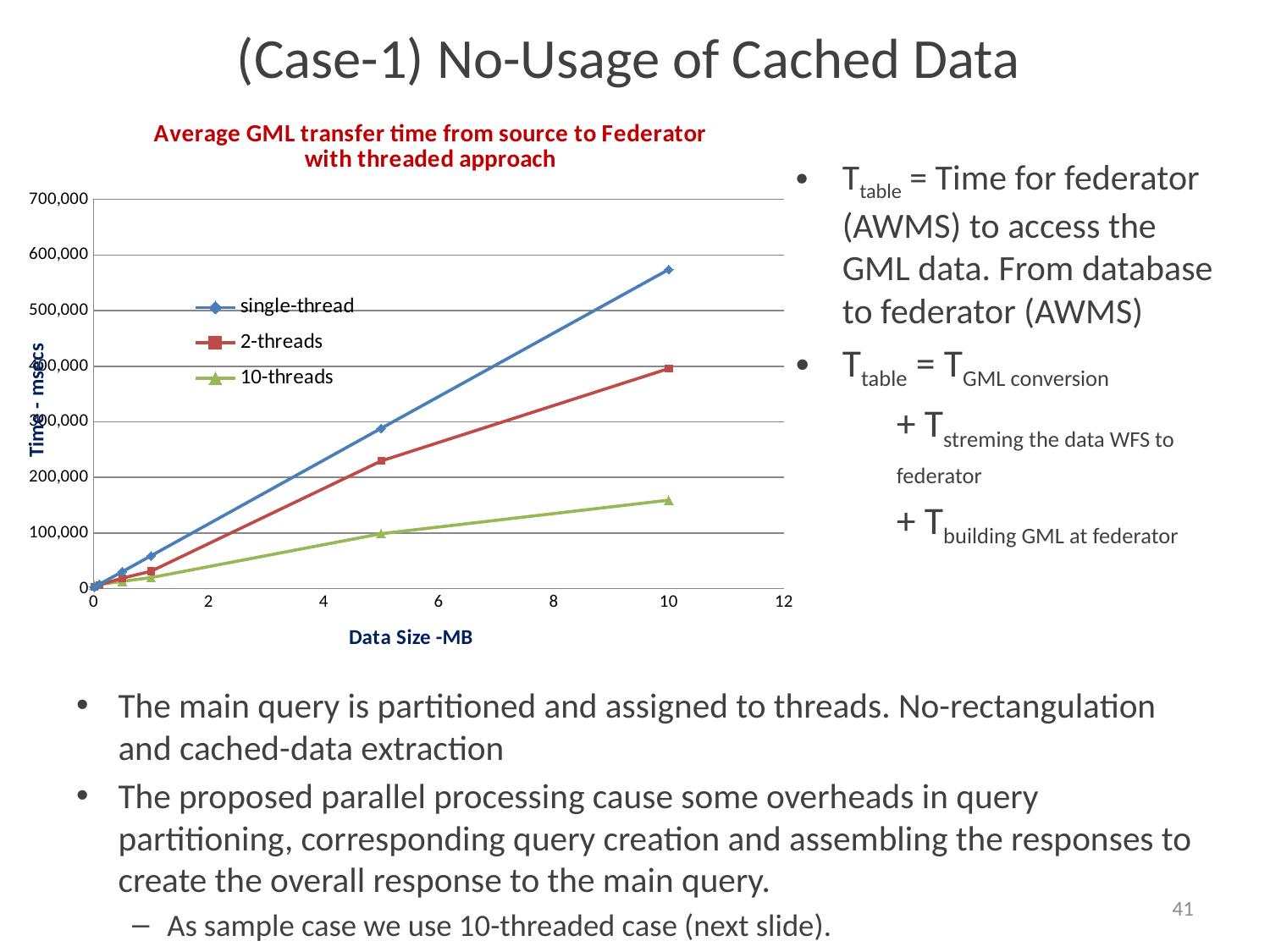
Is the 2-threads transfer time at 10 MB greater or less than 300,000 msecs? greater Is the 2-threads transfer time at 5 MB greater or less than 200,000 msecs? greater Is the 10-threads transfer time at 10 MB greater or less than 200,000 msecs? less Which series has the highest transfer time at a data size of 10 MB? single-thread What kind of chart is shown on the slide? line chart Which series has the lowest transfer time at a data size of 10 MB? 10-threads Does the transfer time for the single-thread series rise or fall as data size increases? rise At a data size of 5 MB, which series has the larger transfer time: 2-threads or 10-threads? 2-threads What is the label of the x axis of the chart? Data Size -MB What is the title of the chart? Average GML transfer time from source to Federator with threaded approach How many series does the chart legend list? 3